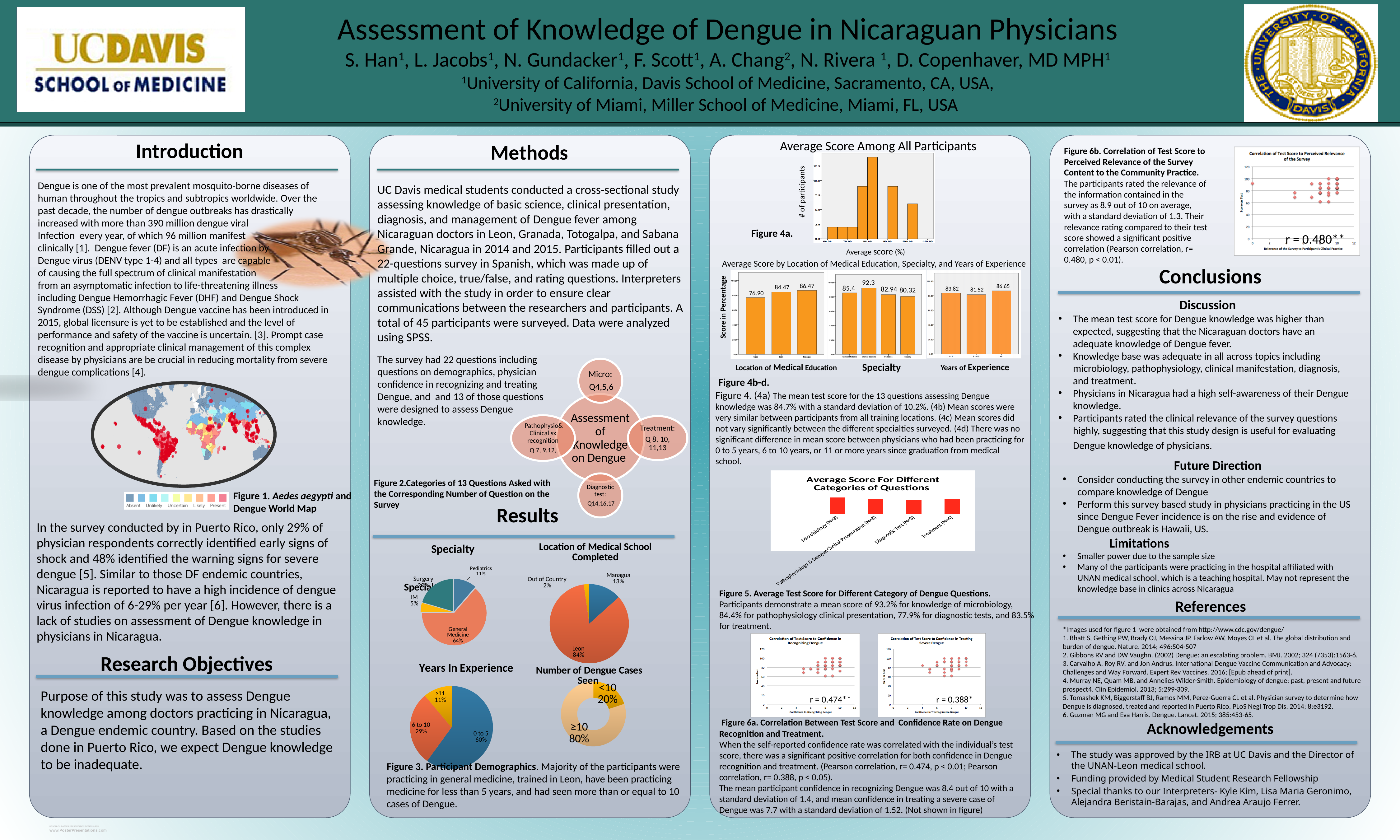
In the 'Years In Experience' pie chart, what share of participants have 0 to 5 years of experience? 60% In the 'Specialty' pie chart, what share of participants are in Pediatrics? 11% In the 'Location of Medical School Completed' pie chart, what share of participants trained in Leon? 84% In the 'Years In Experience' pie chart, which category has the smallest share? >11 In the 'Location of Medical School Completed' pie chart, what share of participants trained out of country? 2% In the 'Specialty' bar chart (Figure 4c), what is the lowest score shown? 80.32 In the 'Years of Experience' bar chart (Figure 4d), what is the highest score shown? 86.65 In the 'Location of Medical Education' bar chart (Figure 4b), what is the highest score shown? 86.47 In the 'Number of Dengue Cases Seen' chart, what share of participants had seen ≥10 cases? 80% How many categories are shown in the 'Average Score For Different Categories of Questions' chart (Figure 5)? 4 In the 'Years In Experience' pie chart, what is the difference between the 0 to 5 share and the 6 to 10 share? 31% In the 'Specialty' pie chart, what share of participants practice General Medicine? 64%